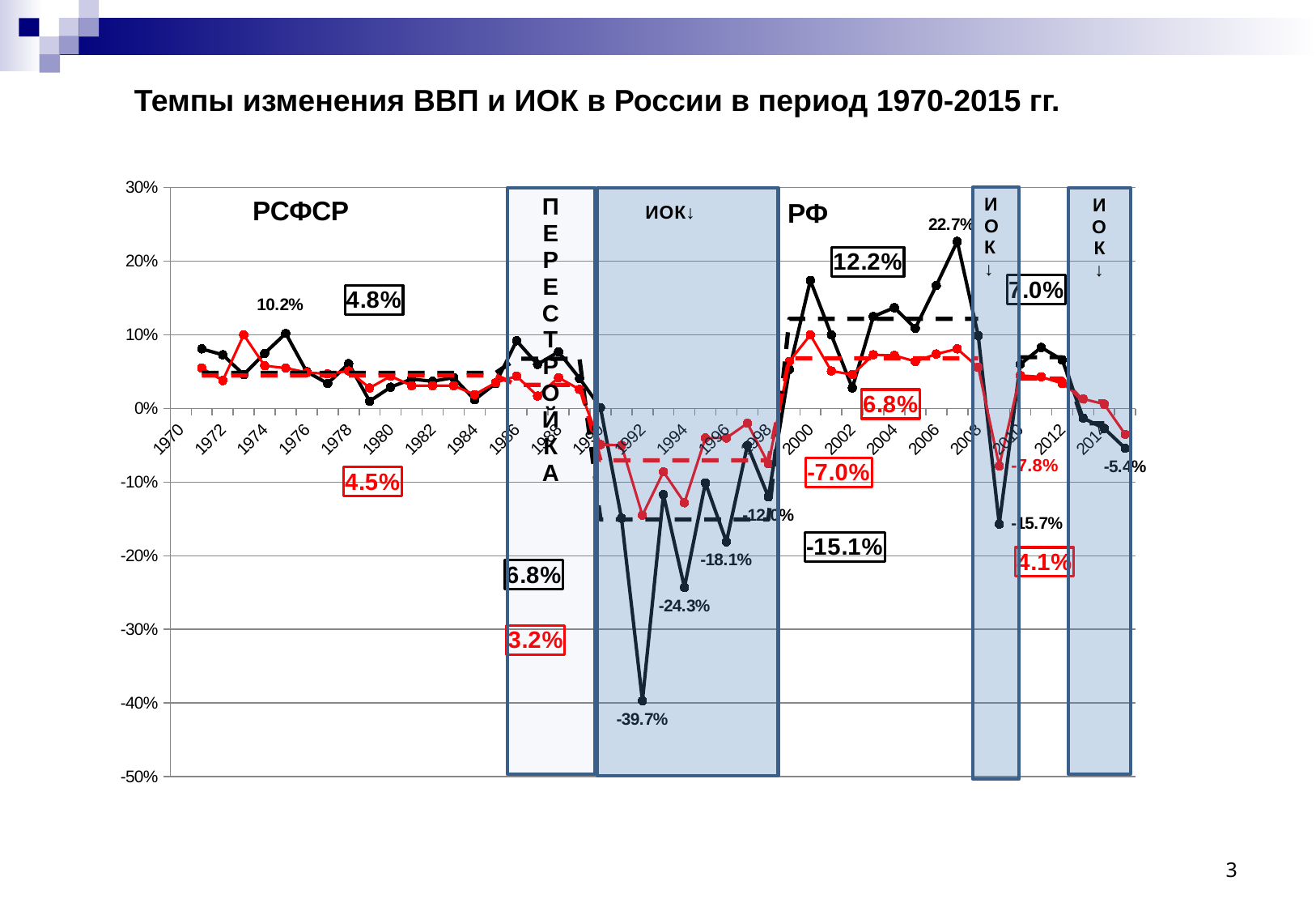
What value is labelled on the black line in 2009? -15.7% What value is labelled at the end of the black line in 2015? -5.4% Is the black line's value in 2000 greater or less than 10%? greater What is the highest value labelled on the black line? 22.7% What is the title of the chart? Темпы изменения ВВП и ИОК в России в период 1970-2015 гг. What kind of chart is shown on the slide? line chart What value is labelled on the black line in 1996? -18.1% What value is labelled on the red line in 2009? -7.8% What value is labelled on the black line in 1994? -24.3% By how many percentage points does the labelled 2007 peak (22.7%) exceed the labelled 1975 peak (10.2%) on the black line? 12.5 What is the lowest value labelled on the black line? -39.7% Which is lower on the black line: the labelled value in 1992 or the labelled value in 1994? 1992